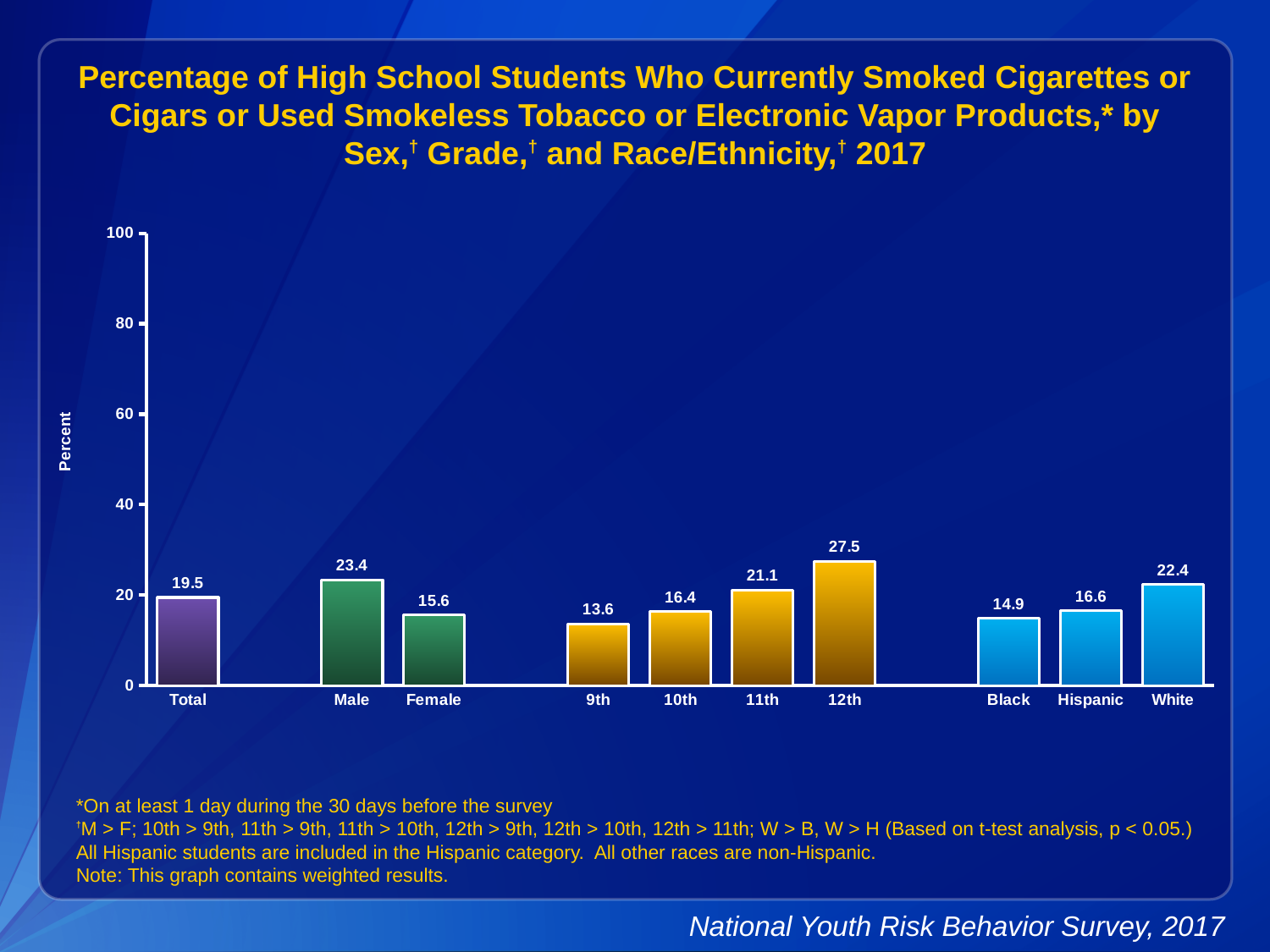
What is the difference between the values for Male and Female? 7.8 What is the value for Total? 19.5 What kind of chart is shown on the slide? bar chart Is the value for Male greater or less than 20? greater Which is larger, the value for 10th grade or the value for 11th grade? 11th What is the value for 12th grade students? 27.5 Which category has the highest value? 12th What is the value for Hispanic students? 16.6 Which category has the lowest value? 9th Do the values rise or fall from 9th grade to 12th grade? rise What is the difference between the values for White and Black? 7.5 How many categories are shown on the x axis? 10